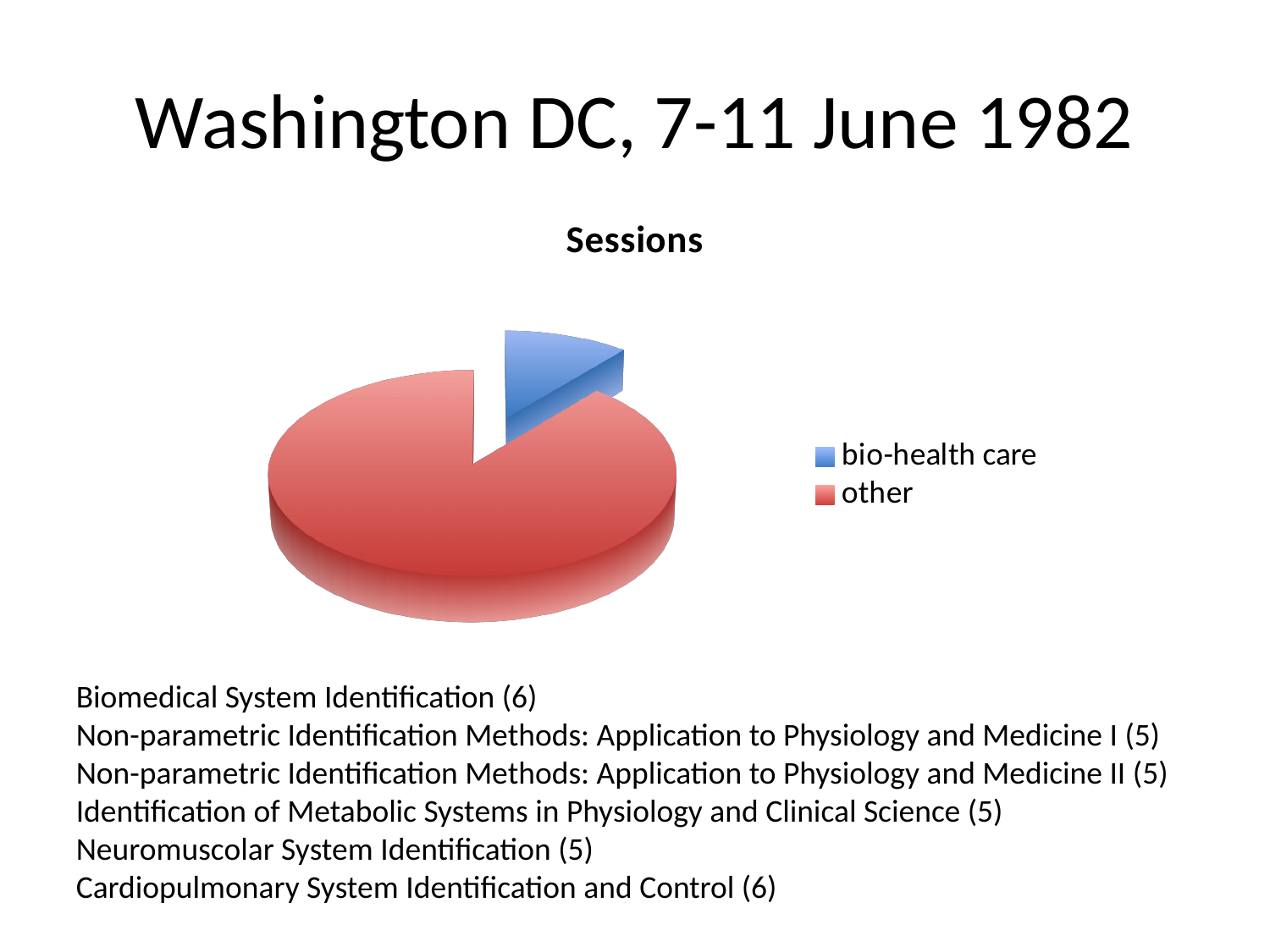
How many slices does the pie chart have? 2 What kind of chart is shown on the slide? pie chart What colour is the bio-health care slice? blue What is the title of the chart? Sessions How many entries does the chart legend list? 2 Which category has the smallest slice of the pie? bio-health care Which slice is larger, bio-health care or other? other Which category has the largest slice of the pie? other